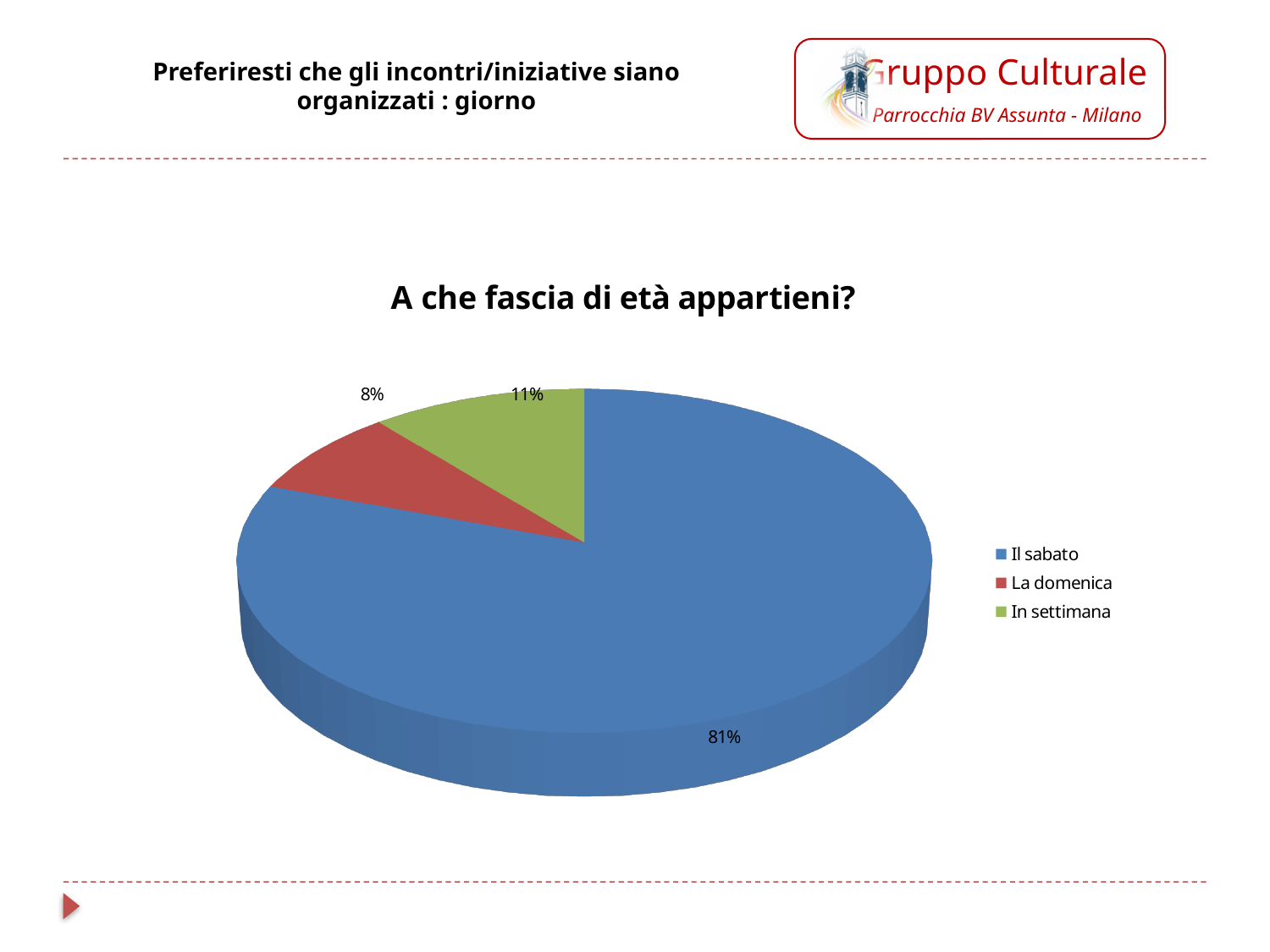
Which category has the largest slice of the pie? Il sabato What colour is the slice for "In settimana"? Green How many categories does the pie chart show? 3 What share of the pie does "Il sabato" represent? 81% What is the title of the chart? A che fascia di età appartieni? Which is larger, the slice for "In settimana" or the slice for "La domenica"? In settimana What share of the pie does "La domenica" represent? 8% What is the difference in percentage points between "Il sabato" and "In settimana"? 70 What is the difference in percentage points between "In settimana" and "La domenica"? 3 What kind of chart is shown on the slide? Pie chart Which category has the smallest slice of the pie? La domenica What share of the pie does "In settimana" represent? 11%